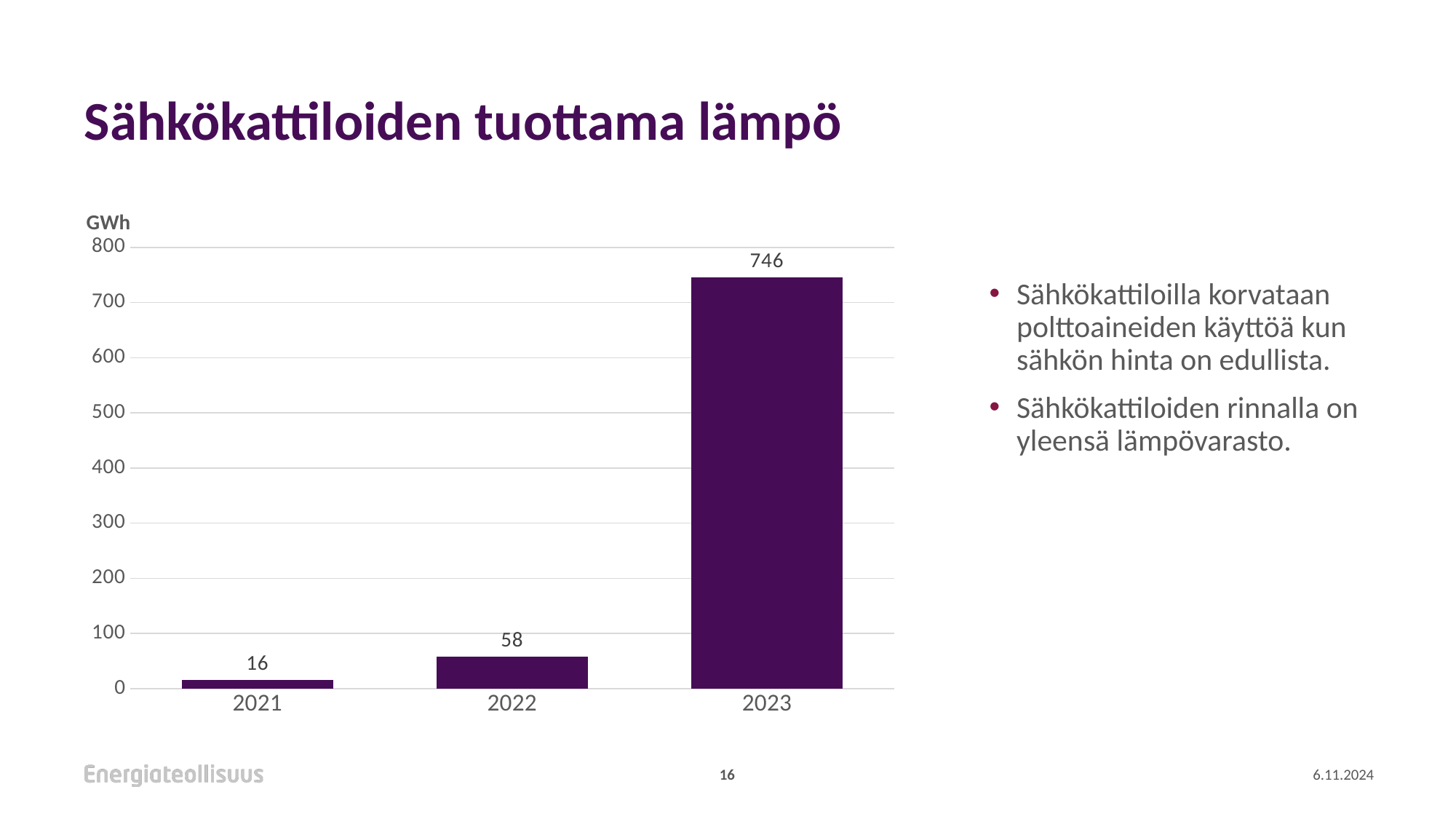
What is the value for 2022? 58 How many years are shown on the x axis? 3 What is the value for 2023? 746 What kind of chart is shown on the slide? bar chart Which year has the highest value? 2023 Is the value for 2023 greater or less than 700? greater Which is larger, the value for 2021 or the value for 2022? 2022 What is the difference between the values for 2022 and 2021? 42 What is the difference between the values for 2023 and 2022? 688 Which year has the lowest value? 2021 What is the value for 2021? 16 Do the values rise or fall from 2021 to 2023? rise